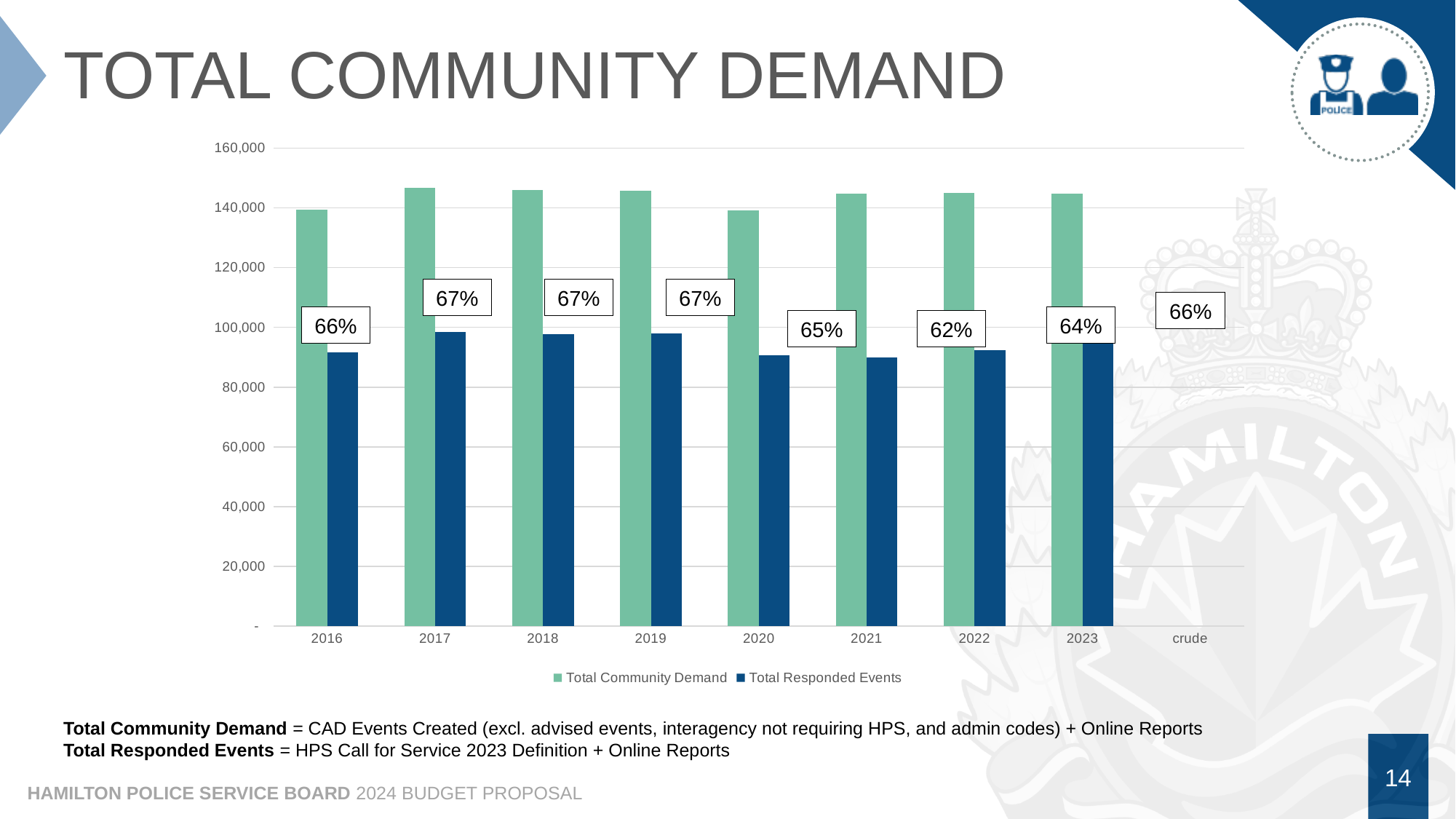
What percentage label is shown for 2016? 66% How many series does the legend list? 2 Is the Total Responded Events value for 2017 greater or less than 100,000? less Which colour represents Total Community Demand? green Which year has the larger Total Community Demand, 2017 or 2020? 2017 Which year has the lowest percentage label? 2021 What kind of chart is shown on the slide? bar chart What percentage label is shown for 2021? 62% What is the difference between the percentage labels for 2019 and 2021? 5% What percentage label is shown for 2023? 66% Is the Total Community Demand value for 2017 greater or less than 140,000? greater What are the two series named in the legend? Total Community Demand and Total Responded Events